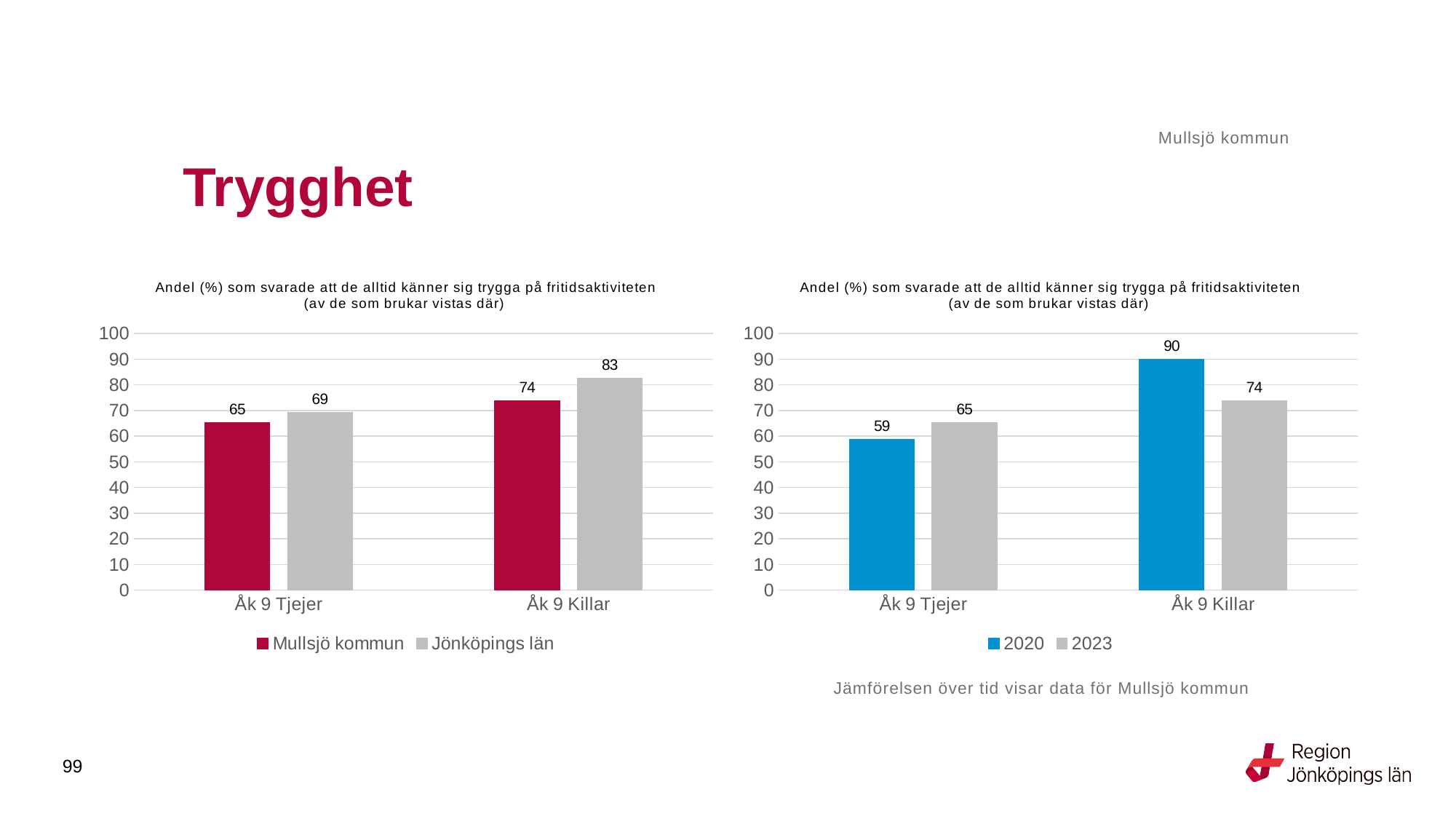
In the right chart, which bar is the highest? 2020, Åk 9 Killar In the right chart, what colour are the 2020 bars? Blue In the right chart, what is the difference between 2020 and 2023 for Åk 9 Killar? 16 In the left chart, which is larger for Åk 9 Tjejer: Mullsjö kommun or Jönköpings län? Jönköpings län In the left chart, what is the value for Jönköpings län for Åk 9 Killar? 83 In the right chart, which bar is the lowest? 2020, Åk 9 Tjejer In the left chart, what is the value for Mullsjö kommun for Åk 9 Tjejer? 65 What kind of chart is the right chart? Bar chart In the right chart, what is the value for 2020 for Åk 9 Killar? 90 In the left chart, what is the difference between Jönköpings län and Mullsjö kommun for Åk 9 Killar? 9 In the left chart, how many series does the legend list? 2 In the right chart, what is the value for 2023 for Åk 9 Tjejer? 65